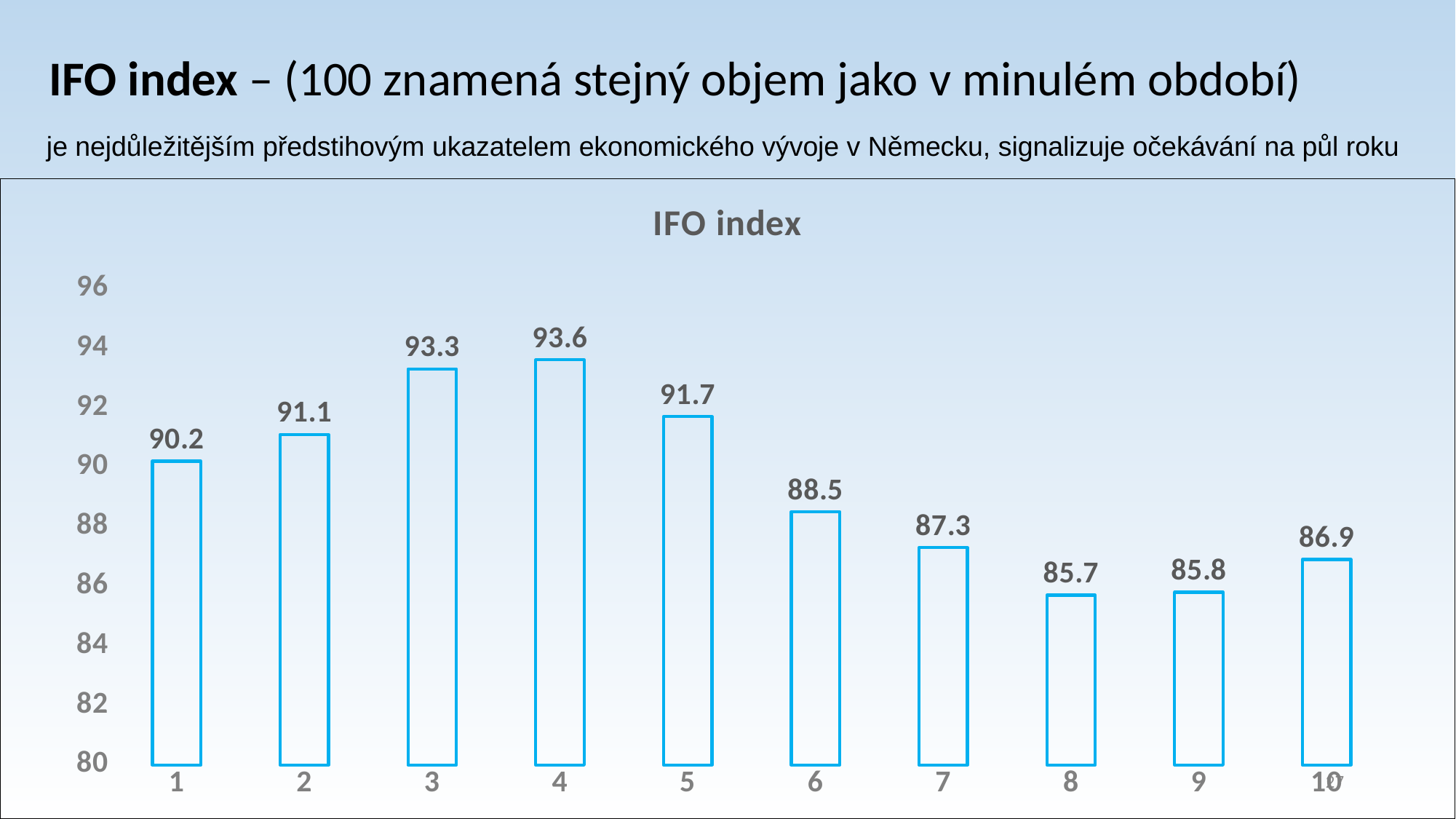
Which has a larger IFO index value, category 5 or category 6? 5 Which category has the lowest IFO index value? 8 What is the difference between the IFO index values for category 3 and category 2? 2.2 How many categories are shown on the x axis of the chart? 10 Do the IFO index values rise or fall from category 4 to category 8? fall Which category has the highest IFO index value? 4 What is the IFO index value for category 8? 85.7 What is the IFO index value for category 1? 90.2 What is the difference between the IFO index values for category 4 and category 8? 7.9 What is the IFO index value for category 4? 93.6 What kind of chart is shown on the slide? bar chart Is the IFO index value for category 7 greater or less than 88? less